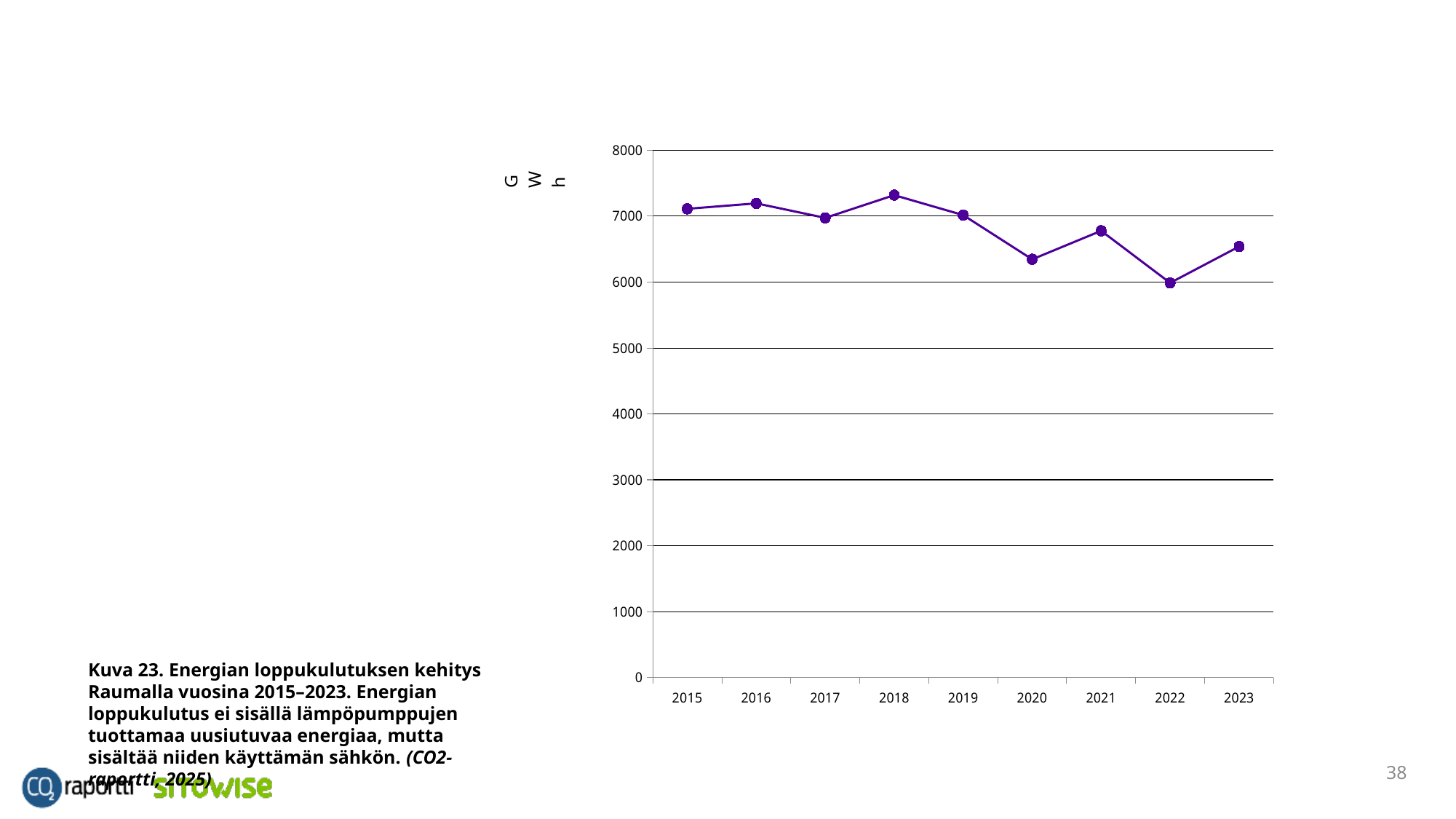
Overall, do the values rise or fall from 2015 to 2023? fall Is the value for 2020 greater or less than 7000? less Which year has the lowest value on the chart? 2022 Is the value for 2018 greater or less than 7000? greater Is the value for 2021 greater or less than 7000? less What unit is shown on the vertical axis label? GWh How many years (data points) are plotted on the chart? 9 Which is larger, the value for 2018 or the value for 2020? 2018 Which is larger, the value for 2021 or the value for 2022? 2021 Which year has the highest value on the chart? 2018 What kind of chart is shown on the slide? line chart